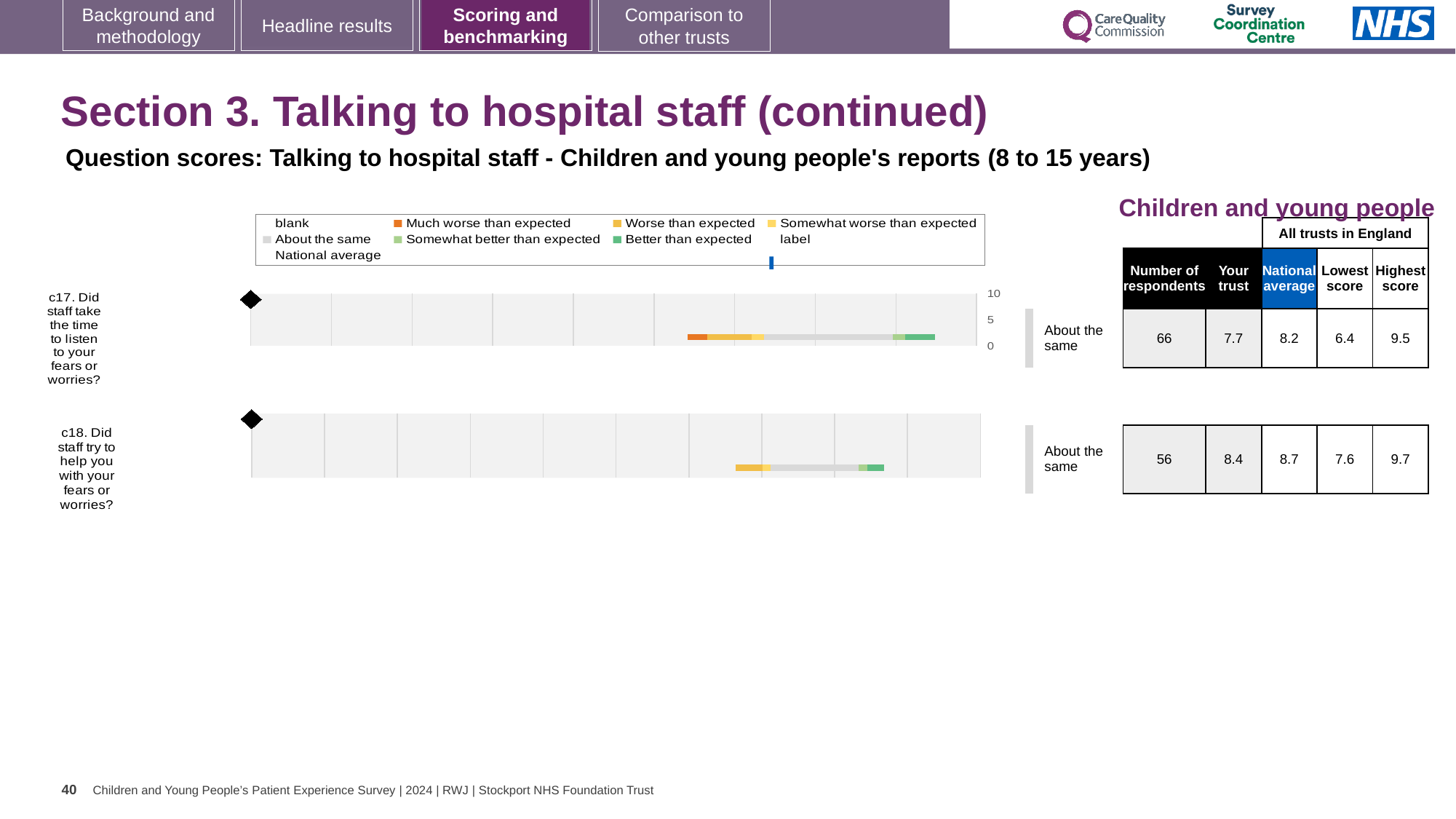
Is the 'Your trust' score for c17 greater or less than 5 on the chart axis? greater What is the difference between the national average and the 'Your trust' score for c17? 0.5 What kind of chart is used to show the c17 and c18 question scores? bar chart What is the 'Your trust' score for c17 (Did staff take the time to listen to your fears or worries?)? 7.7 What is the national average score for c17 (Did staff take the time to listen to your fears or worries?)? 8.2 What is the 'Your trust' score for c18 (Did staff try to help you with your fears or worries?)? 8.4 How many questions (categories) are plotted on the slide? 2 What is the difference between the highest and lowest trust scores for c18? 2.1 What is the highest score among all trusts in England for c18? 9.7 How many respondents answered c17? 66 What benchmark category is shown next to both the c17 and c18 bars? About the same Which question has the higher 'Your trust' score, c17 or c18? c18